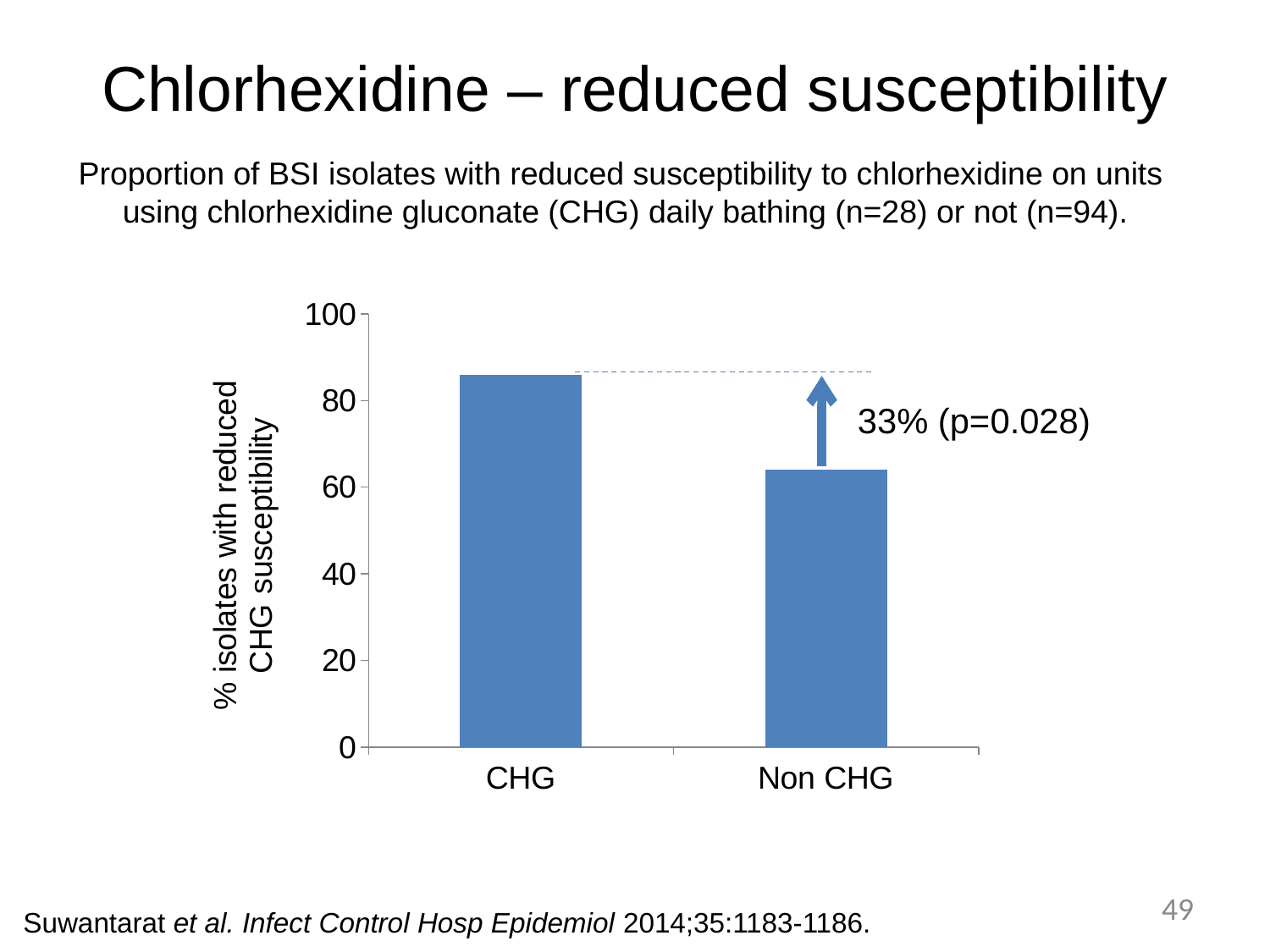
What type of chart is shown on the slide? bar chart Which category has the lowest value in the chart? Non CHG How many categories are plotted on the x axis of the chart? 2 Is the value for CHG greater or less than 100? less Is the value for Non CHG greater or less than 80? less Which category has the highest value in the chart? CHG Which category has the higher bar, CHG or Non CHG? CHG What annotation is printed next to the arrow above the Non CHG bar? 33% (p=0.028) Is the value for CHG greater or less than 80? greater What is the label on the y axis of the chart? % isolates with reduced CHG susceptibility What is the maximum value shown on the y axis of the chart? 100